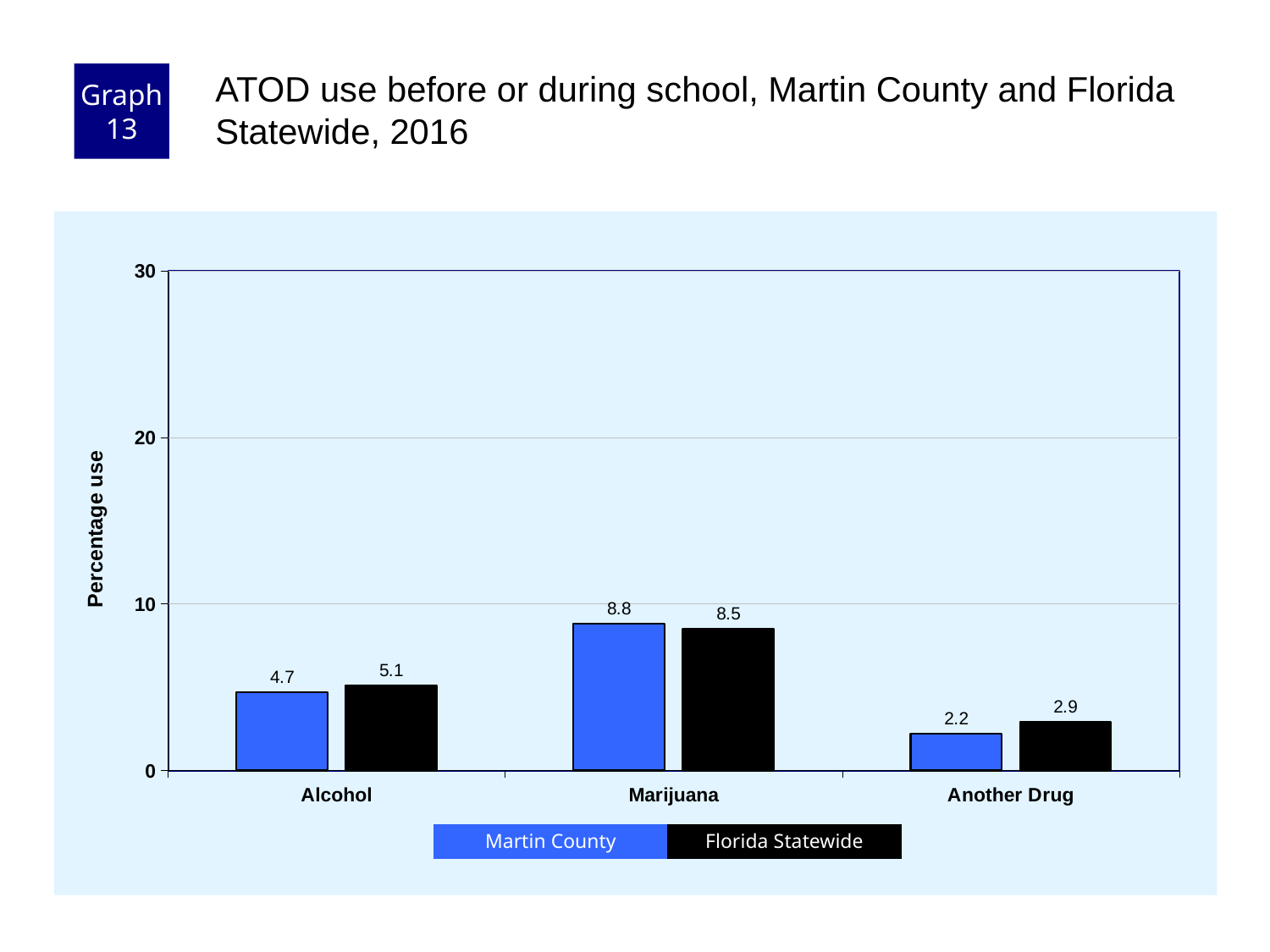
Is the Martin County value for Marijuana greater or less than 10? less What is the difference between the Martin County values for Marijuana and Another Drug? 6.6 What is the Florida Statewide value for Another Drug? 2.9 What is the Florida Statewide value for Marijuana? 8.5 What is the Martin County value for Alcohol? 4.7 How many categories are shown on the x axis? 3 For Another Drug, which is larger: Martin County or Florida Statewide? Florida Statewide Which category has the lowest Florida Statewide value? Another Drug What kind of chart is shown on the slide? bar chart How many series does the legend list? 2 Which category has the highest Martin County value? Marijuana What is the difference between the Florida Statewide and Martin County values for Alcohol? 0.4